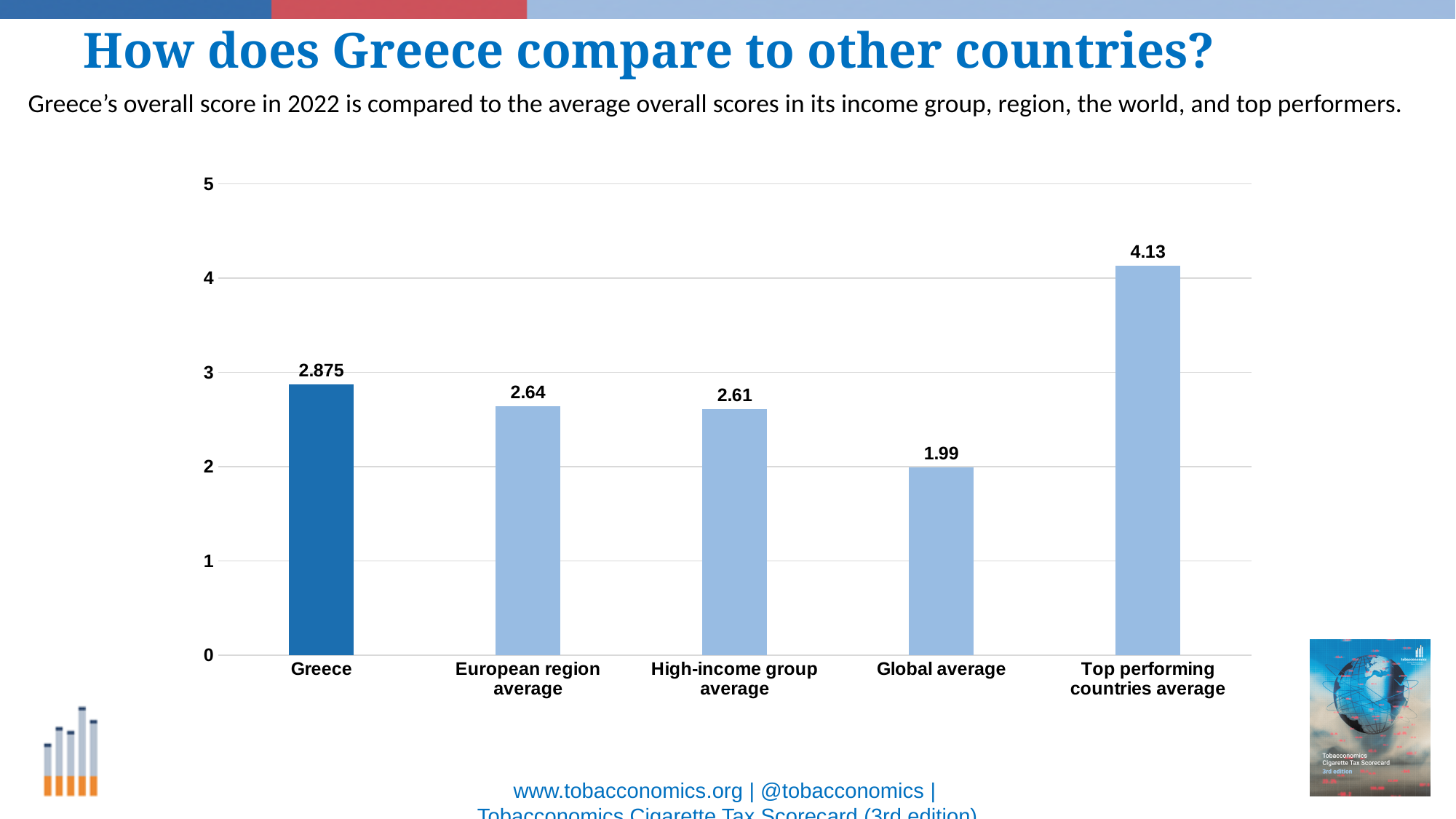
Is the value for the Top performing countries average greater or less than 4? greater Which category has the highest value? Top performing countries average What is the value for the Top performing countries average? 4.13 Which bar is shown in a darker blue than the others? Greece What is the value for the Global average? 1.99 How many categories are shown on the chart? 5 What is the difference between the Top performing countries average and Greece? 1.255 What is the value for Greece? 2.875 What is the difference between the European region average and the Global average? 0.65 What kind of chart is shown on the slide? Bar chart Which category has the lowest value? Global average Which is larger, Greece or the High-income group average? Greece